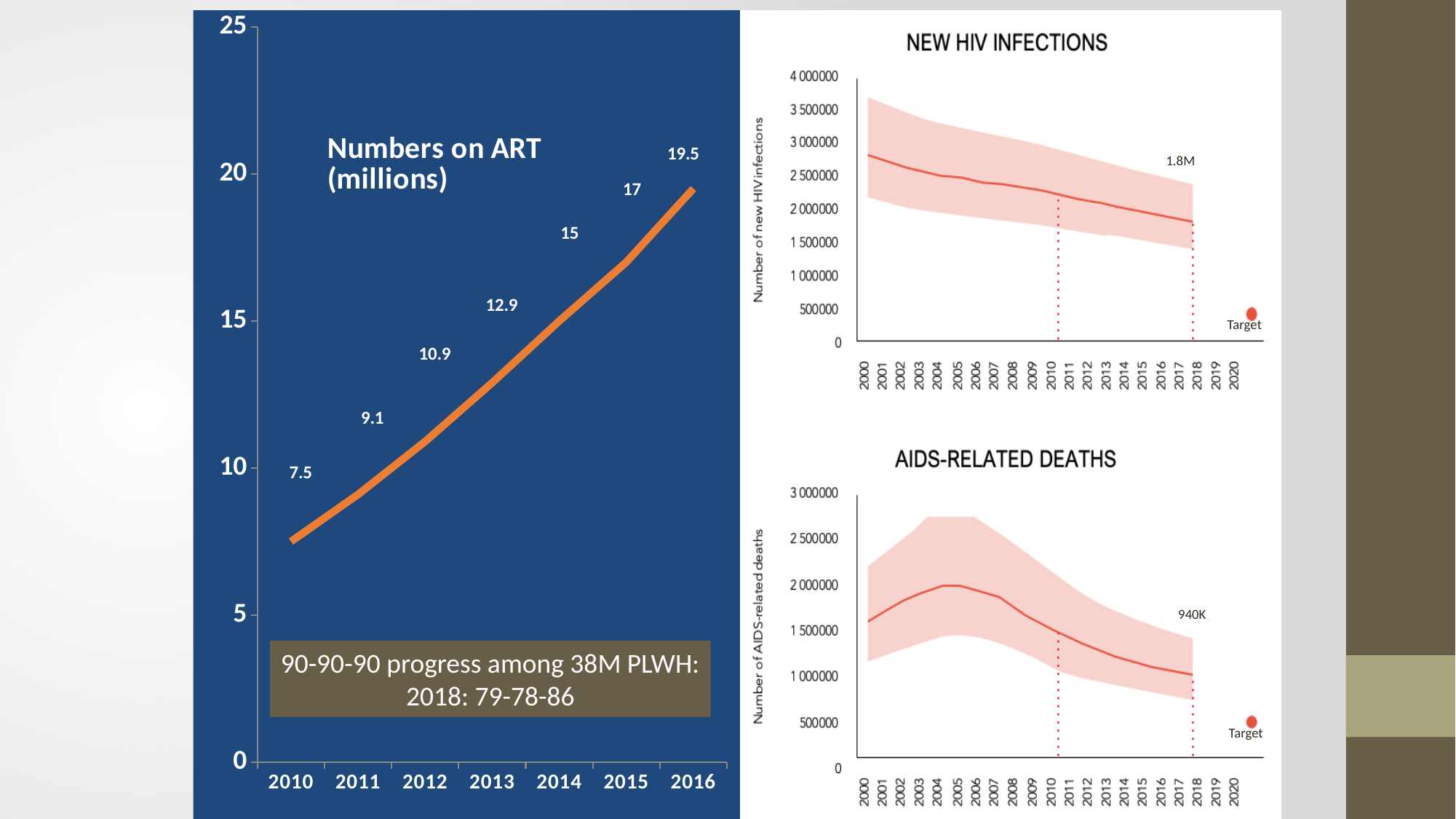
In the 'NEW HIV INFECTIONS' chart, is the value for 2000 greater or less than 2 500 000? greater In the 'Numbers on ART (millions)' chart, do the values rise or fall from 2010 to 2016? rise In the 'AIDS-RELATED DEATHS' chart, what value is labelled at 2018? 940K In the 'Numbers on ART (millions)' chart, which year has the highest value? 2016 In the 'Numbers on ART (millions)' chart, what is the value for 2010? 7.5 In the 'Numbers on ART (millions)' chart, what is the value for 2016? 19.5 In the 'Numbers on ART (millions)' chart, how many years are plotted on the x axis? 7 In the 'Numbers on ART (millions)' chart, what is the value for 2013? 12.9 In the 'NEW HIV INFECTIONS' chart, what value is labelled at 2018? 1.8M In the 'Numbers on ART (millions)' chart, which year has the lowest value? 2010 What kind of chart is the 'Numbers on ART (millions)' chart? line chart In the 'Numbers on ART (millions)' chart, what is the difference between the 2016 and 2010 values? 12